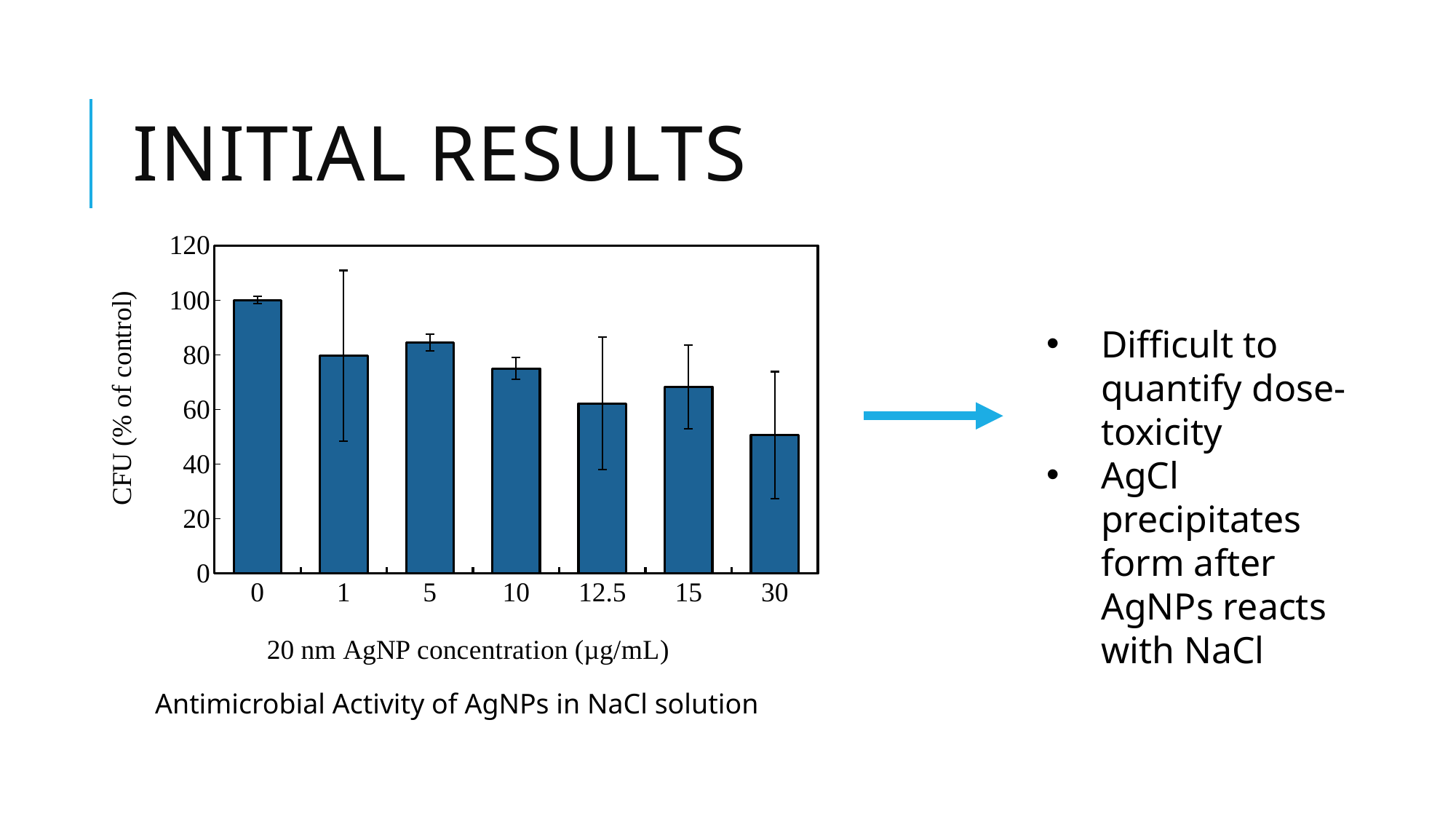
Is the CFU (% of control) value for the 5 µg/mL concentration greater or less than 80? greater What is the label of the x axis of the chart? 20 nm AgNP concentration (µg/mL) Which AgNP concentration has the highest CFU (% of control)? 0 Which AgNP concentration has the lowest CFU (% of control)? 30 Is the CFU (% of control) value for the 10 µg/mL concentration greater or less than 80? less What kind of chart is shown on the slide? bar chart Overall, do the CFU (% of control) values rise or fall as the AgNP concentration increases along the x axis? fall Is the CFU (% of control) value for the 30 µg/mL concentration greater or less than 60? less How many AgNP concentration categories are plotted on the x axis? 7 Which has a higher CFU (% of control): the 5 µg/mL or the 10 µg/mL concentration? 5 µg/mL What is the CFU (% of control) value for the 0 µg/mL concentration? 100